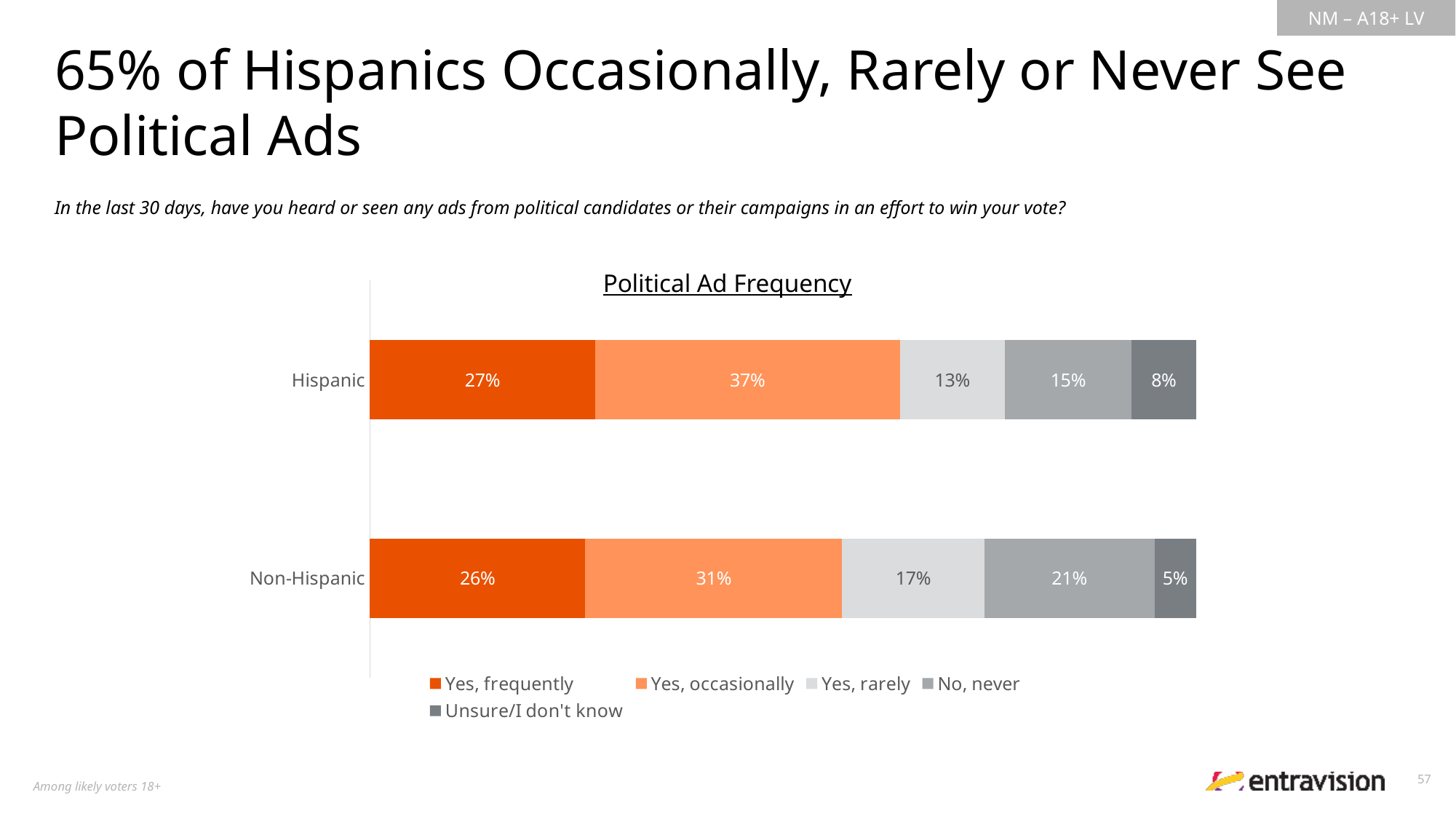
Which response category has the lowest share among Non-Hispanic respondents? Unsure/I don't know What is the 'Yes, occasionally' value for Hispanic respondents? 37% How many groups (bars) are shown in the chart? 2 What percentage of Hispanic respondents said they see political ads 'Yes, frequently'? 27% What type of chart is shown on the slide? Stacked bar chart How many series does the legend list? 5 What is the title of the chart? Political Ad Frequency What percentage of Non-Hispanic respondents answered 'No, never'? 21% Which group has a larger 'No, never' share, Hispanic or Non-Hispanic? Non-Hispanic Which response category has the highest share among Hispanic respondents? Yes, occasionally What is the difference between the 'Yes, occasionally' values for Hispanic and Non-Hispanic respondents? 6 percentage points What is the 'Unsure/I don't know' value for Non-Hispanic respondents? 5%